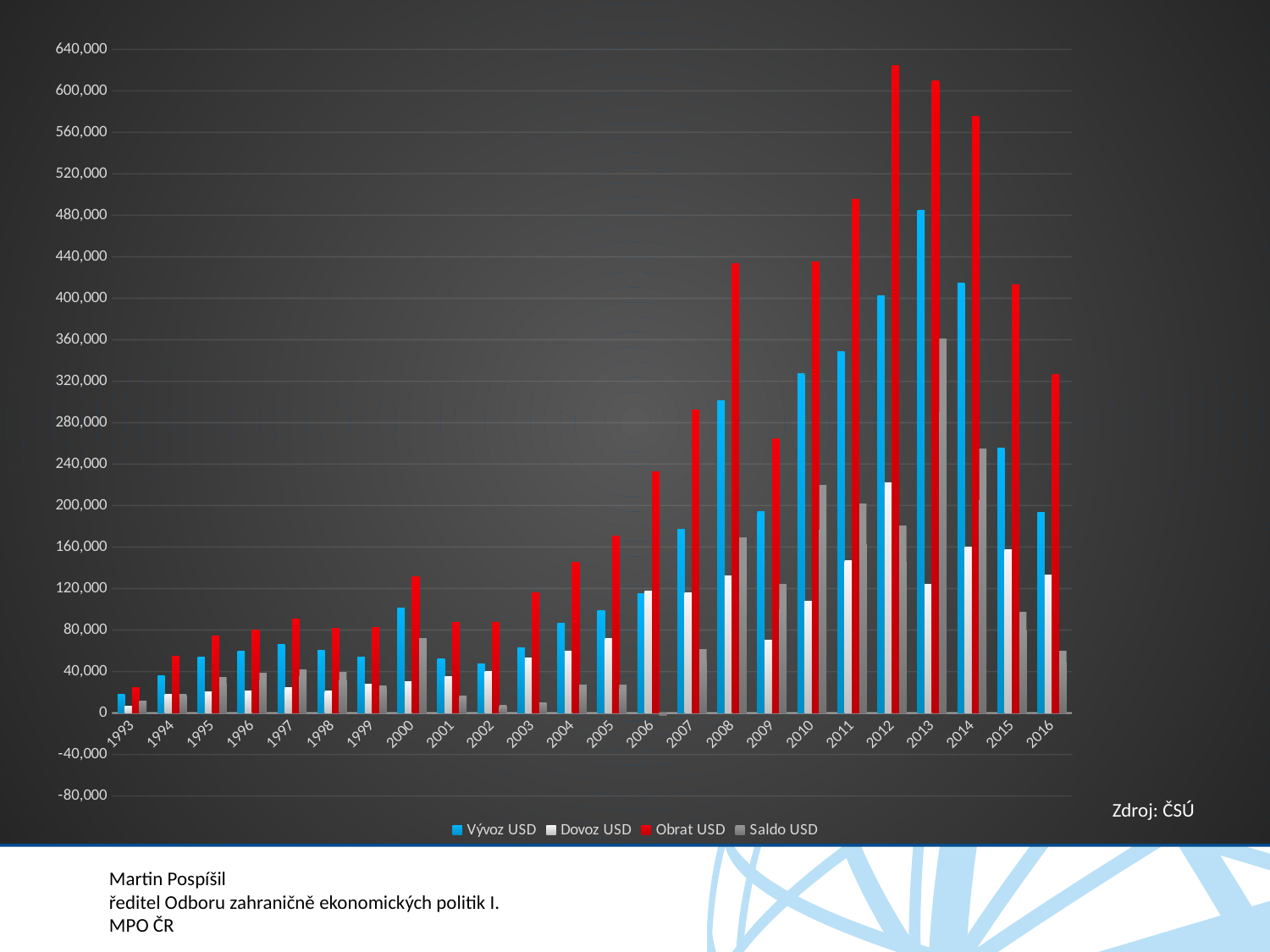
Is the Obrat USD value for 1993 greater or less than 40,000? less In which year is the Obrat USD value highest? 2012 What kind of chart is shown on the slide? bar chart In which year is the Obrat USD value lowest? 1993 How many series does the legend list? 4 Which series is shown in red? Obrat USD Is the Obrat USD value for 2012 greater or less than 600,000? greater Which is larger, the Vývoz USD value for 2014 or for 2015? 2014 Is the Saldo USD value for 2013 greater or less than 400,000? less Does the Obrat USD series generally rise or fall from 1993 to 2012? rise How many years are shown on the x axis? 24